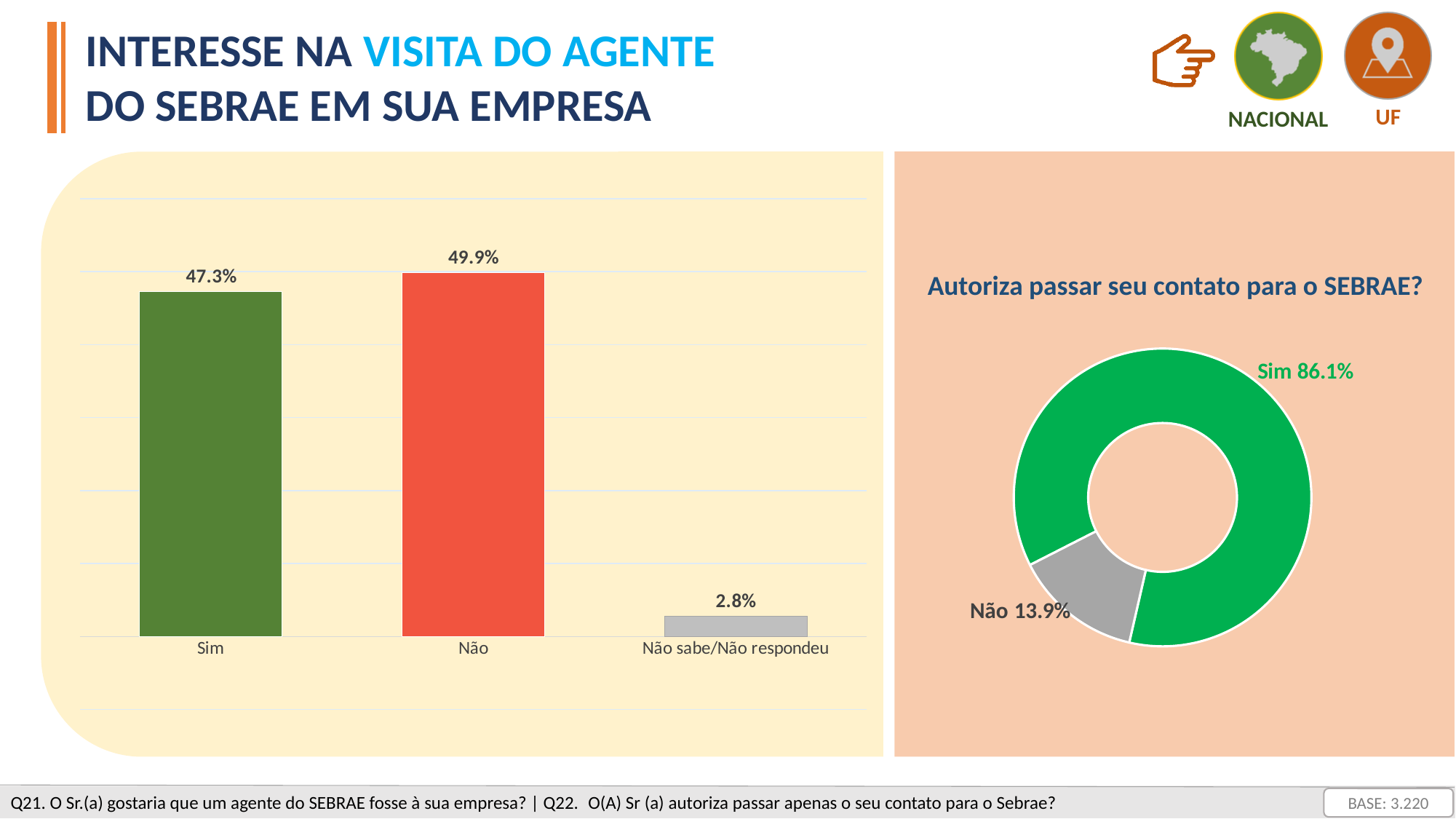
In the chart titled "Autoriza passar seu contato para o SEBRAE?", what is the value for "Sim"? 86.1% In the bar chart on the left, what is the value for "Não sabe/Não respondeu"? 2.8% What kind of chart is shown on the right side of the slide? Doughnut chart What kind of chart is shown on the left side of the slide? Bar chart In the bar chart on the left, what is the value for "Sim"? 47.3% In the bar chart on the left, how many categories are shown? 3 In the bar chart on the left, which category has the lowest value? Não sabe/Não respondeu In the bar chart on the left, which category has the highest value? Não In the chart titled "Autoriza passar seu contato para o SEBRAE?", what is the value for "Não"? 13.9% In the bar chart on the left, what is the difference between the values for "Não" and "Sim"? 2.6% In the chart titled "Autoriza passar seu contato para o SEBRAE?", which is larger, "Sim" or "Não"? Sim In the bar chart on the left, what is the value for "Não"? 49.9%